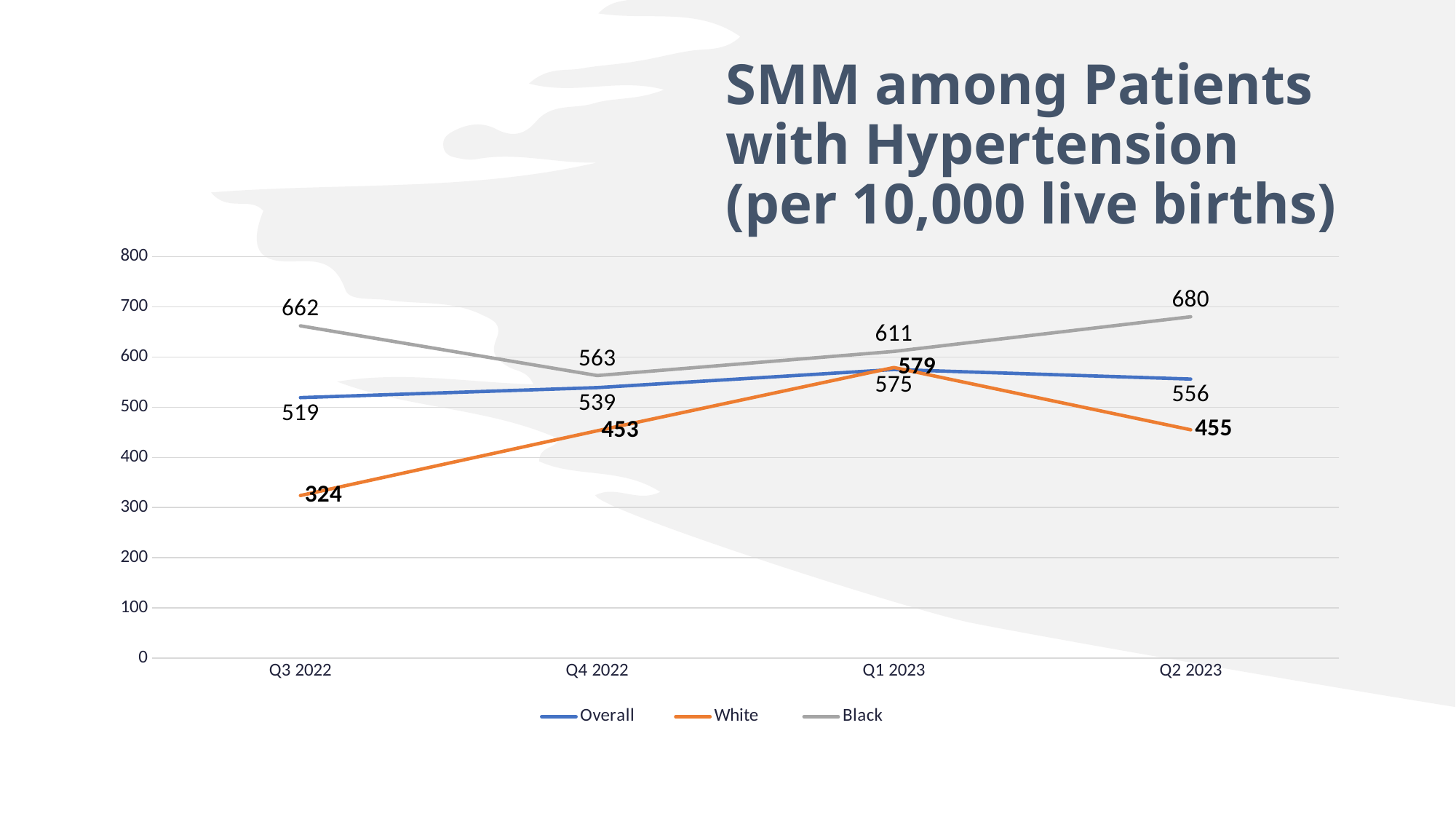
Is the value for Black in Q3 2022 greater or less than 600? greater What is the value for Overall in Q4 2022? 539 How many quarters are shown on the x axis? 4 In which quarter is the Black series at its lowest? Q4 2022 What is the value for Black in Q2 2023? 680 What is the value for White in Q3 2022? 324 Does the White series rise or fall from Q3 2022 to Q1 2023? Rise What is the difference between the Black and White values in Q3 2022? 338 How many series does the legend list? 3 In which quarter is the White series at its highest? Q1 2023 Which is larger in Q2 2023, the Overall value or the White value? Overall What kind of chart is shown on the slide? Line chart